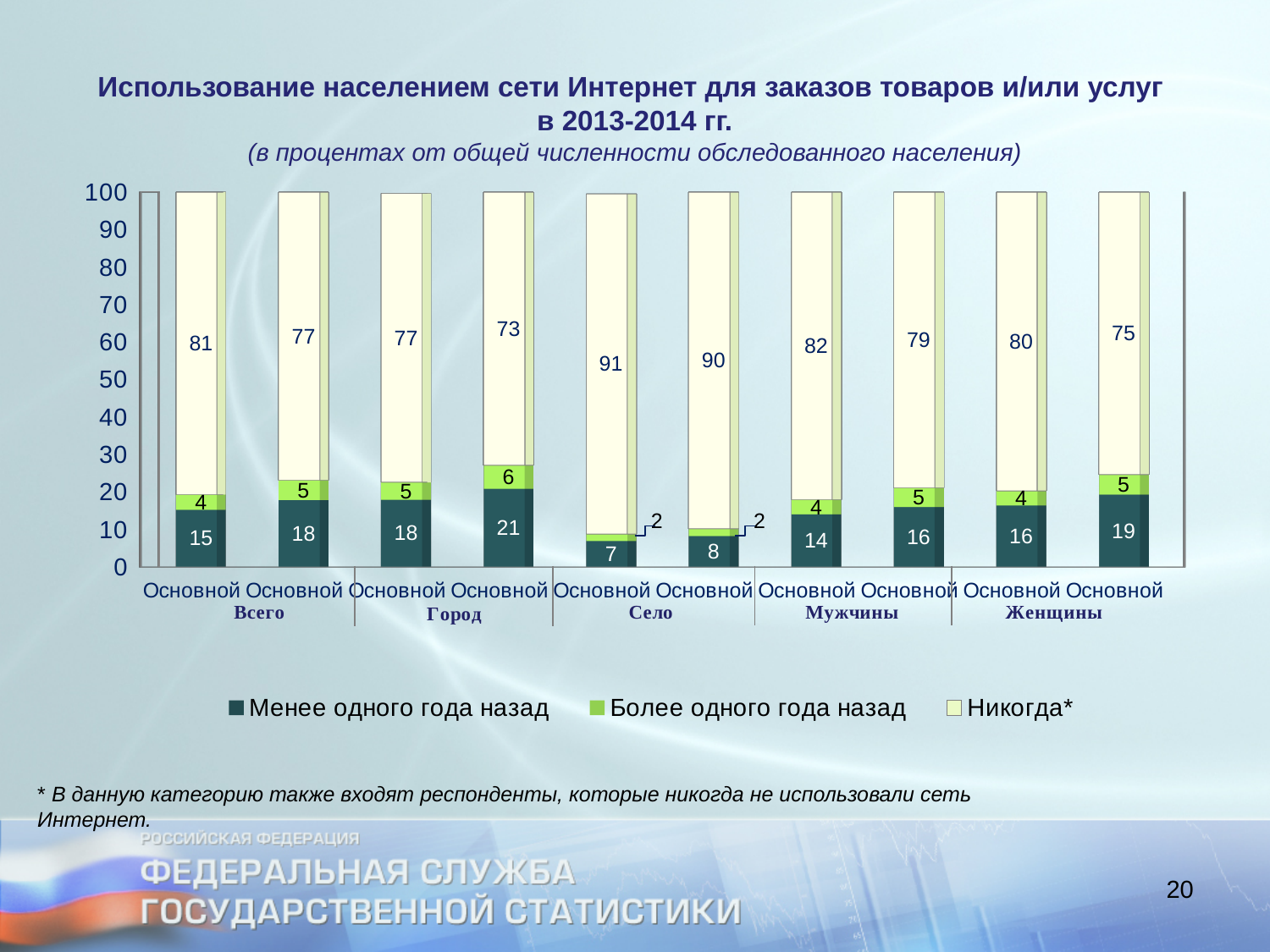
Which legend entry is marked with an asterisk? Никогда* Which group has the lowest 'Менее одного года назад' value in its first bar? Село Which is larger: the 'Никогда*' value in the second bar of 'Мужчины' or in the second bar of 'Женщины'? Мужчины How many groups of bars are shown along the x axis? 5 What kind of chart is shown on the slide? Stacked bar chart What is the value of the 'Менее одного года назад' segment in the second bar of the 'Город' group? 21 What is the value of the 'Никогда*' segment in the first bar of the 'Село' group? 91 What is the value of the 'Более одного года назад' segment in the second bar of the 'Женщины' group? 5 Which bar has the highest 'Никогда*' value? First bar of Село What is the difference between the 'Менее одного года назад' values of the second and first bars in the 'Всего' group? 3 What is the total of the first bar in the 'Всего' group? 100 How many series does the legend list? 3